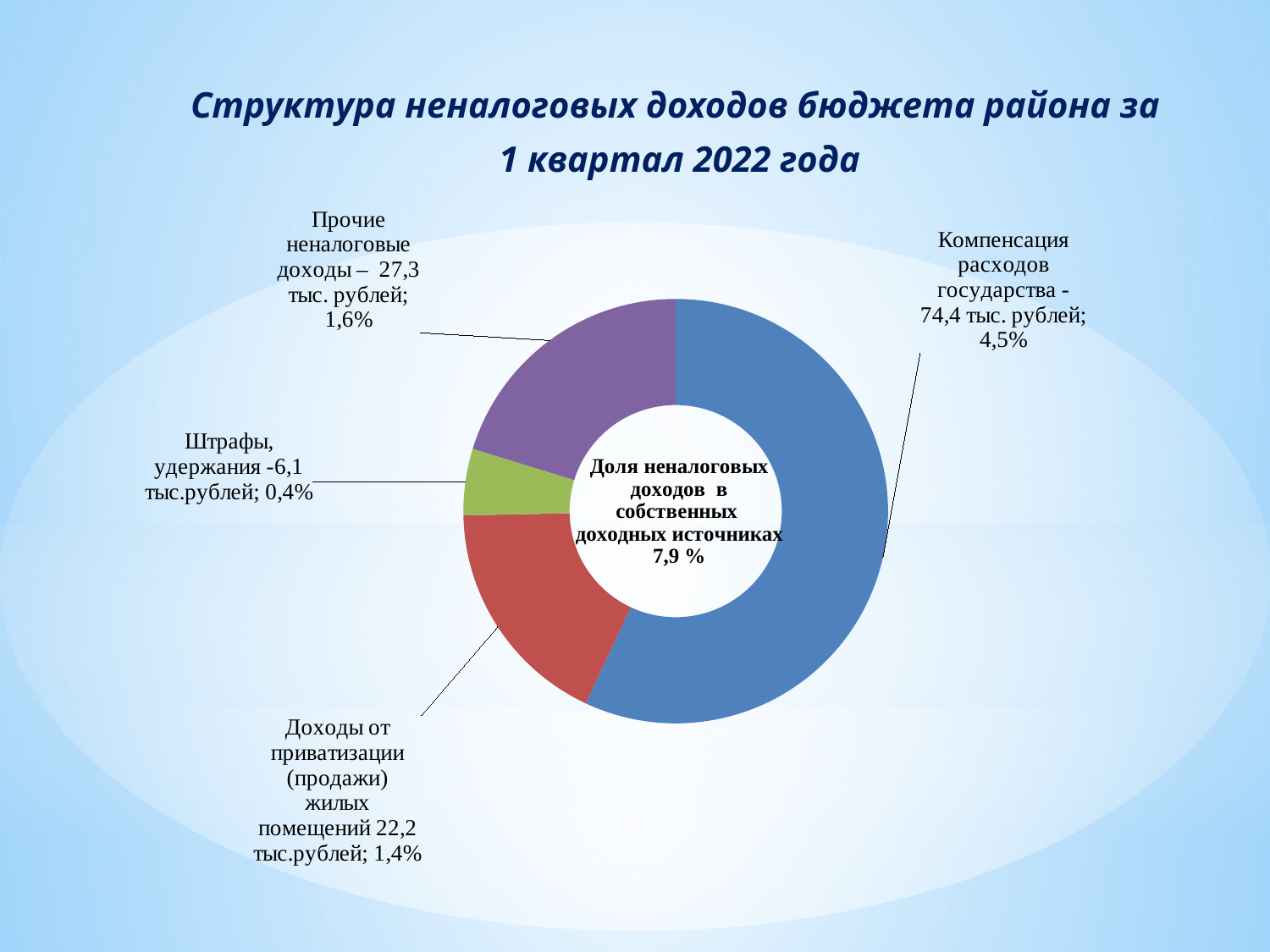
What is the value for Штрафы, удержания? 6,1 тыс.рублей Which is larger: Прочие неналоговые доходы or Доходы от приватизации (продажи) жилых помещений? Прочие неналоговые доходы How many segments does the chart have? 4 What is the value for Доходы от приватизации (продажи) жилых помещений? 22,2 тыс.рублей What is the value for Компенсация расходов государства? 74,4 тыс. рублей Which category has the smallest segment? Штрафы, удержания What kind of chart is shown on the slide? Pie chart (doughnut) Which category has the largest segment? Компенсация расходов государства What share of own revenue sources do non-tax revenues make up, according to the text in the centre of the chart? 7,9 % What percentage is shown for Компенсация расходов государства? 4,5% What is the difference between Компенсация расходов государства and Прочие неналоговые доходы? 47,1 тыс. рублей What is the value for Прочие неналоговые доходы? 27,3 тыс. рублей